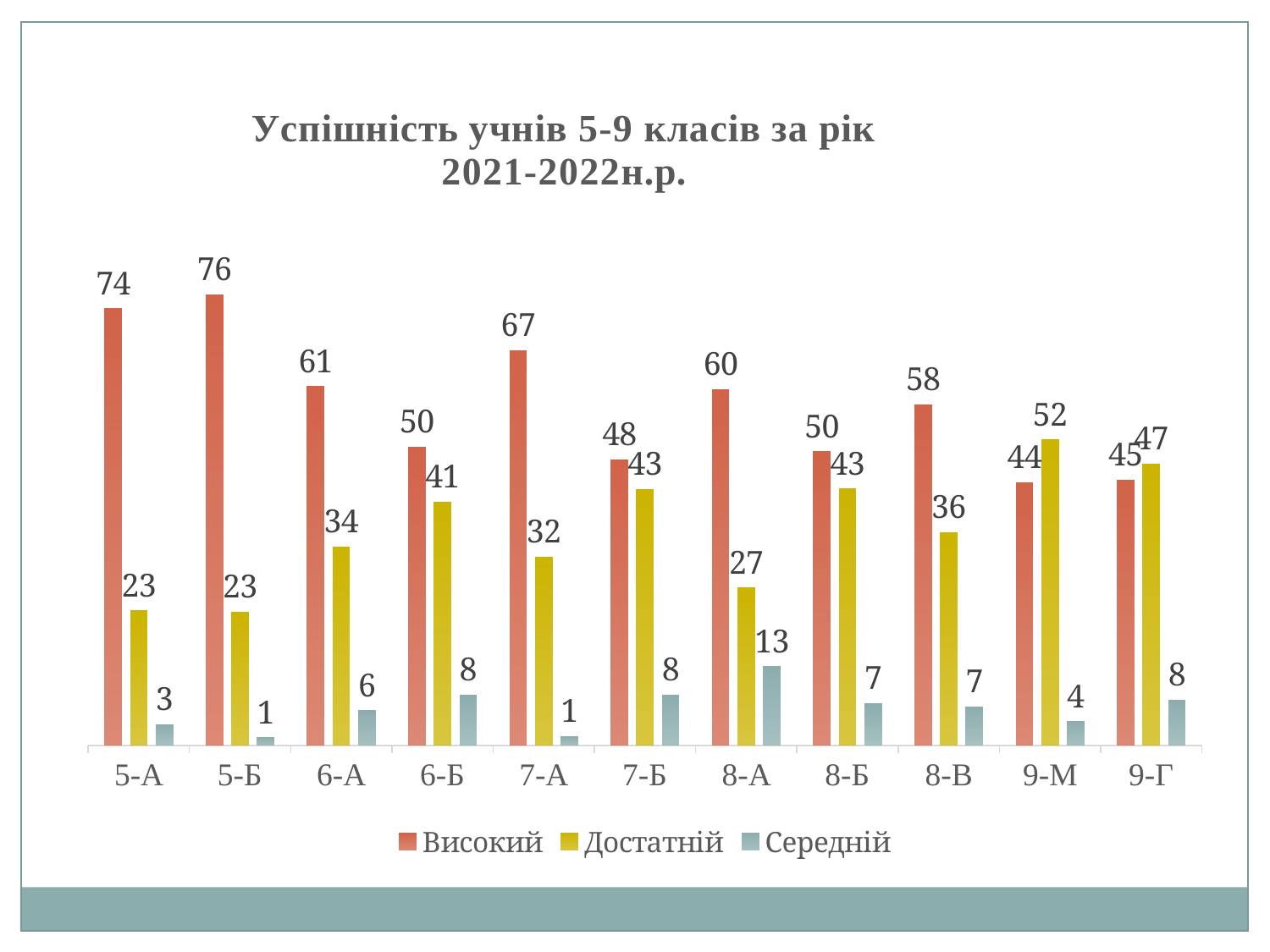
Which is larger, the Достатній value for 7-Б or for 8-В? 7-Б What is the title of the chart? Успішність учнів 5-9 класів за рік 2021-2022н.р. Which class has the lowest Високий value? 9-М Which class has the highest Високий value? 5-Б What is the value of Достатній for 9-М? 52 What kind of chart is shown on the slide? Bar chart How many series does the legend list? 3 How many classes are shown on the x axis? 11 Which class has the highest Середній value? 8-А What is the difference between the Високий values for 5-А and 6-А? 13 What is the value of Високий for 5-Б? 76 What is the value of Середній for 8-А? 13